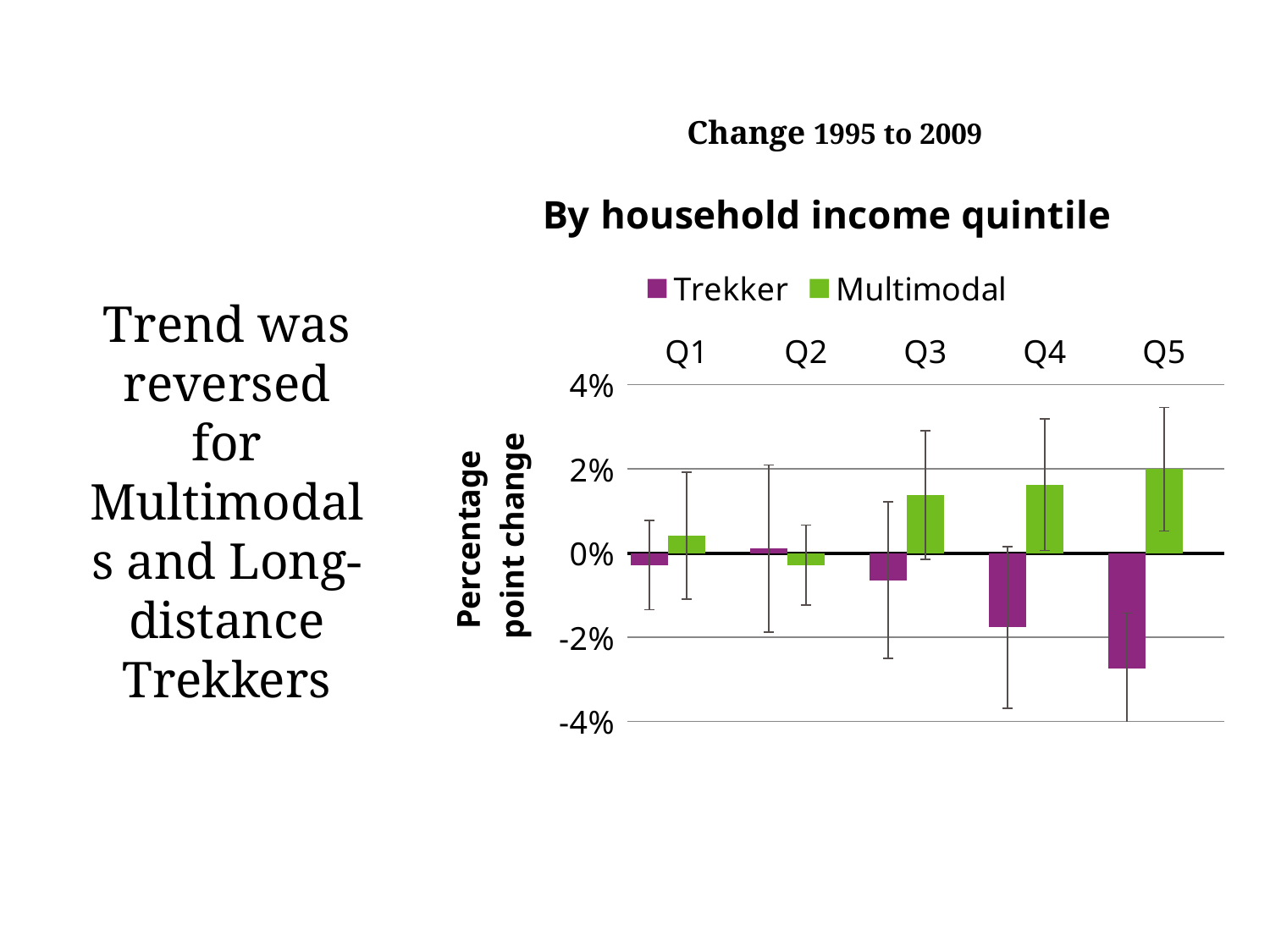
For Q5, which series has the larger value, Trekker or Multimodal? Multimodal Do the Trekker values rise or fall from Q2 to Q5? fall Which series is shown in green? Multimodal How many income quintile categories are shown on the x axis? 5 Is the Multimodal value for Q4 greater or less than 0%? greater Is the Trekker value for Q4 greater or less than 0%? less How many series does the legend list? 2 What is the title of the chart? By household income quintile For which quintile is the Multimodal value highest? Q5 What kind of chart is shown on the slide? bar chart Is the Trekker value for Q5 greater or less than -2%? less For which quintile is the Trekker value lowest? Q5